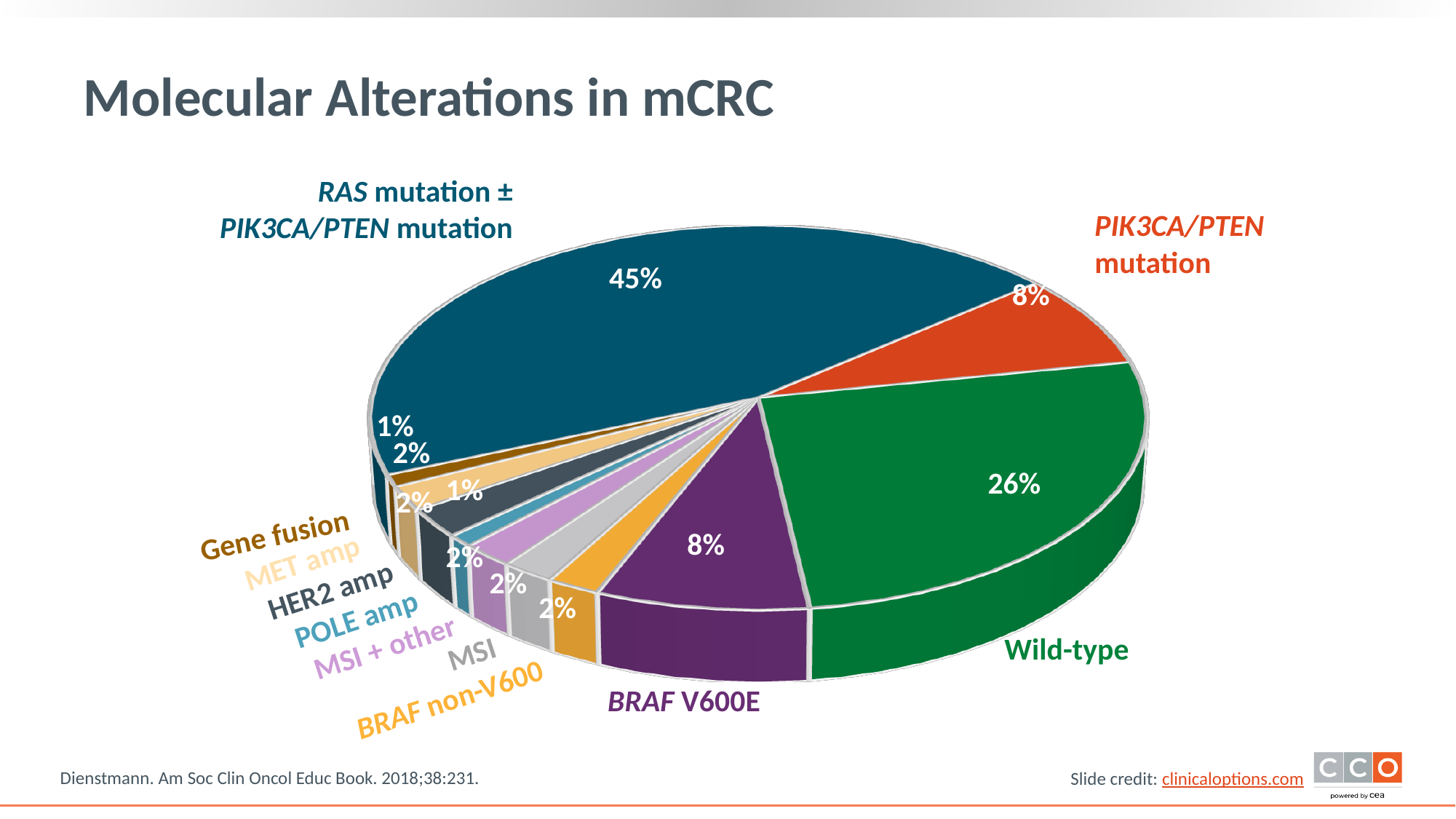
How many categories are shown in the pie chart? 11 What percentage of the pie is BRAF V600E? 8% What percentage of the pie is PIK3CA/PTEN mutation? 8% What is the difference in percentage points between the RAS mutation ± PIK3CA/PTEN mutation slice and the Wild-type slice? 19 What percentage of the pie is RAS mutation ± PIK3CA/PTEN mutation? 45% Which category has the largest share of the pie? RAS mutation ± PIK3CA/PTEN mutation What colour is the Wild-type slice? green What is the title of the chart? Molecular Alterations in mCRC What percentage of the pie is Wild-type? 26% What type of chart is shown on the slide? pie chart Which is larger, the Wild-type slice or the BRAF V600E slice? Wild-type What percentage of the pie is BRAF non-V600? 2%